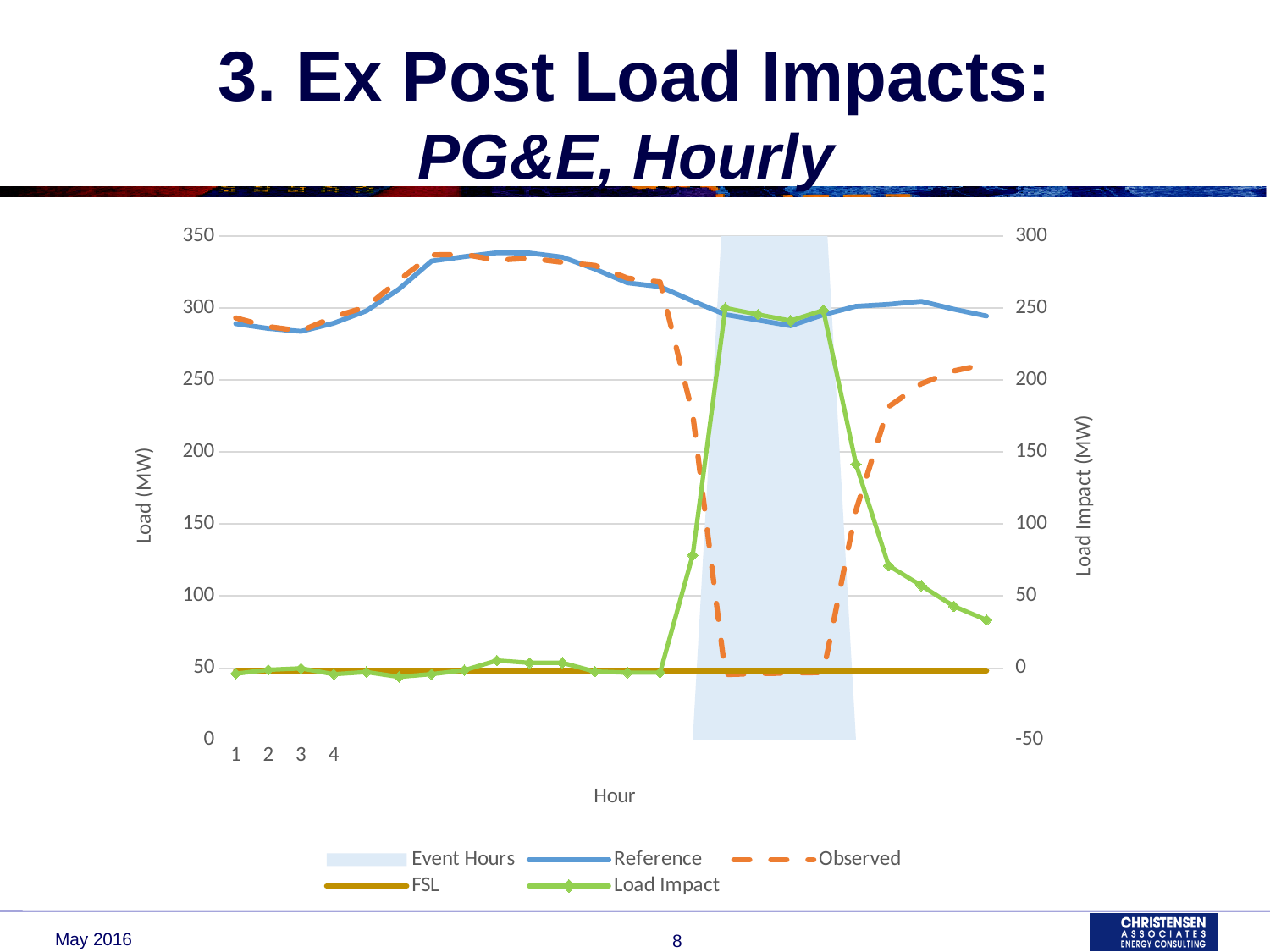
How many entries does the chart legend list? 5 What kind of chart is shown on the slide? line chart What is the title of the left vertical axis? Load (MW) Which series is drawn as a dashed orange line? Observed What is the title of the right vertical axis? Load Impact (MW) Is the Reference value at hour 1 greater or less than 250 on the left axis? greater Is the highest point of the Reference line greater or less than 300 on the left axis? greater During the shaded Event Hours, is the Load Impact value greater or less than 200 on the right axis? greater